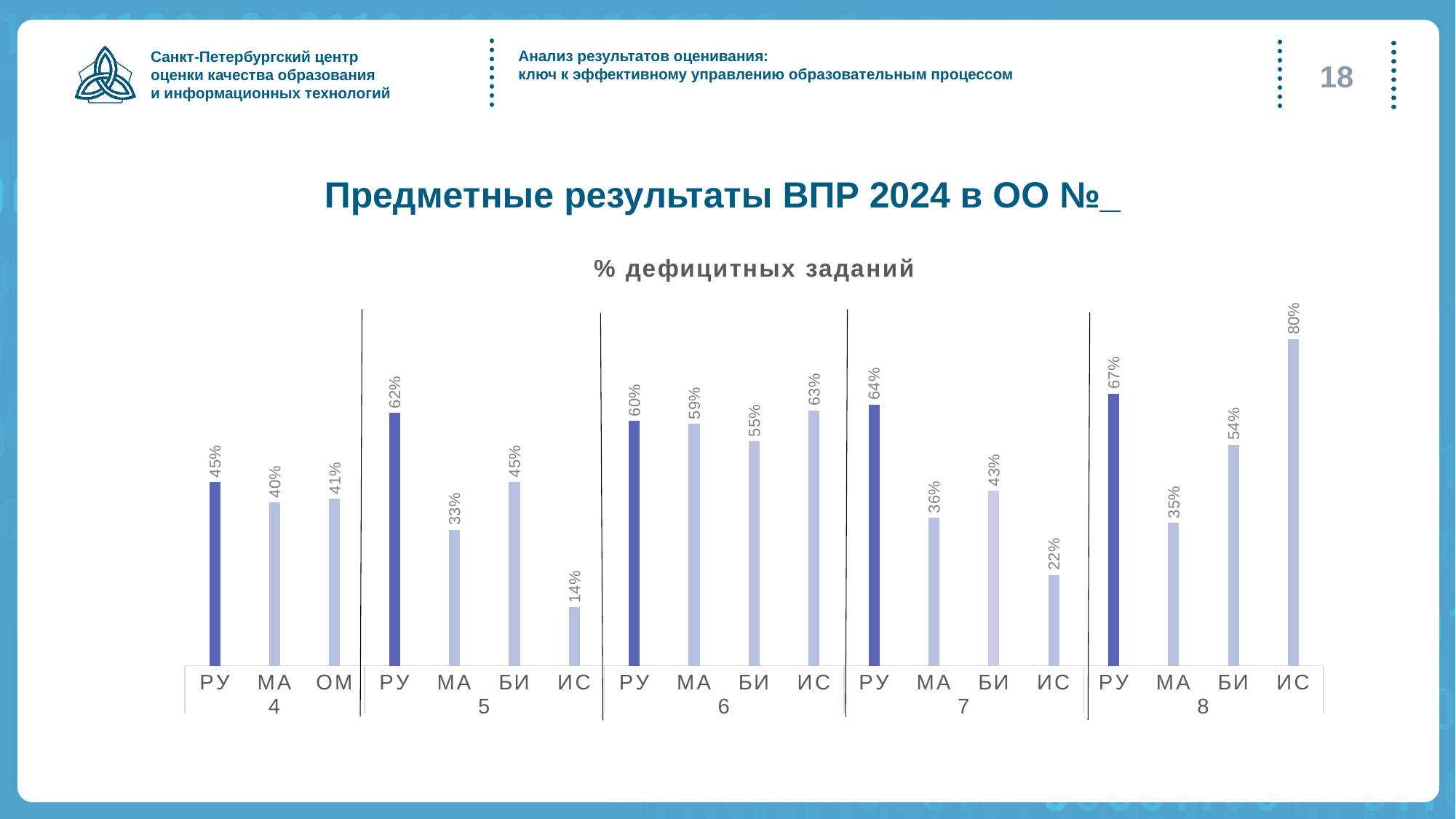
What kind of chart is shown on the slide? Bar chart Which is larger in grade 8: МА or БИ? БИ What is the value for МА in grade 7? 36% What is the value for ИС in grade 8? 80% What is the title of the chart? % дефицитных заданий How many bars are plotted on the chart in total? 19 Which bar has the highest value on the chart? ИС in grade 8 (80%) What is the value for ОМ in grade 4? 41% Which is larger in grade 6: РУ or ИС? ИС What is the value for РУ in grade 5? 62% What is the difference between РУ and ИС in grade 7? 42% Which bar has the lowest value on the chart? ИС in grade 5 (14%)